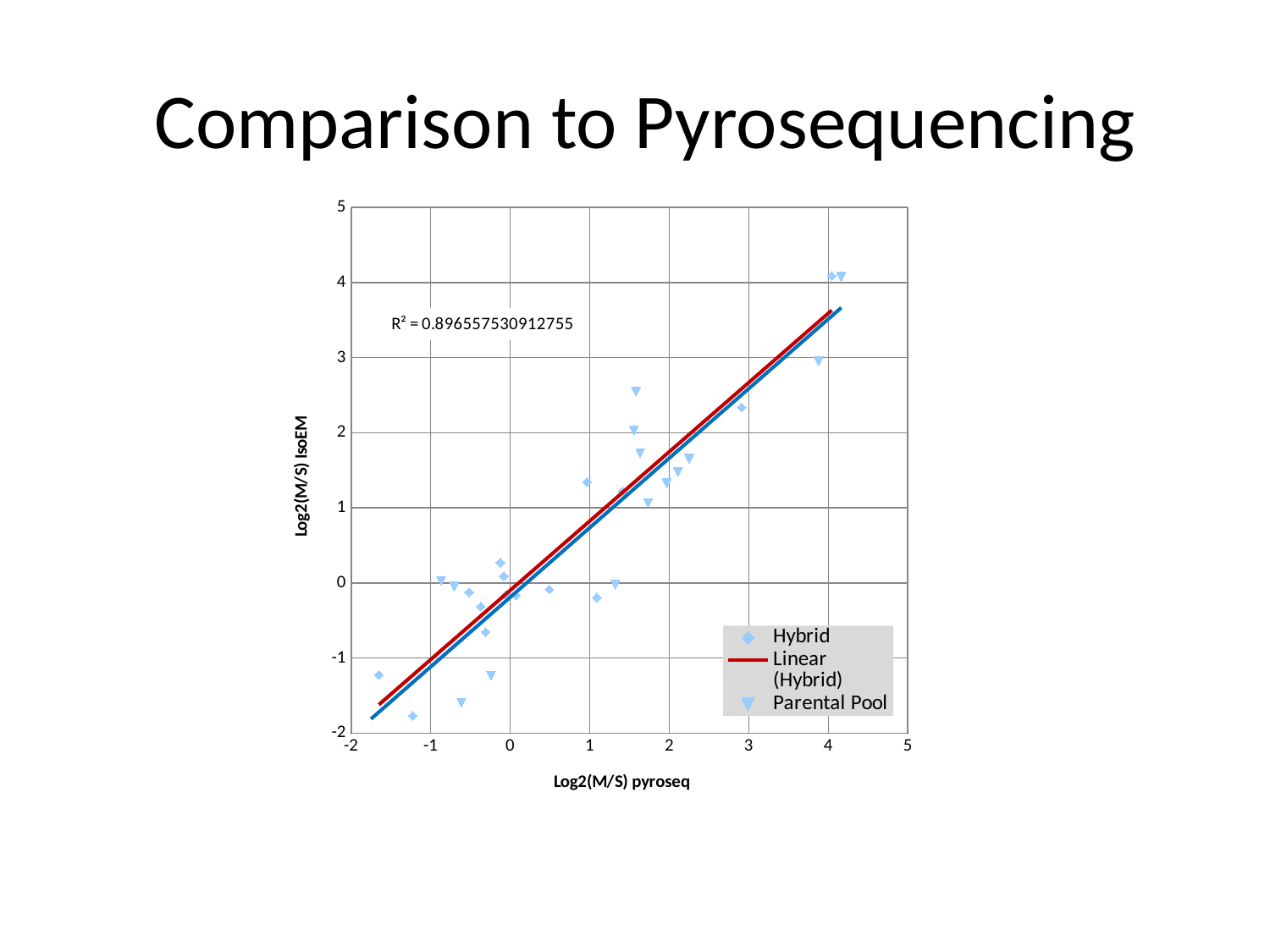
What kind of chart is shown on the slide? Scatter chart What is the R² value printed on the chart? 0.896557530912755 Is the R² value shown on the chart greater or less than 0.9? less What is the minimum value shown on the x axis? -2 Is the y value of the lowest plotted point greater or less than -1? less How many entries does the chart legend list? 3 What is the maximum value shown on the y axis? 5 Is the y value of the highest plotted point greater or less than 3? greater Do the plotted points generally rise or fall as the x-axis value increases? Rise